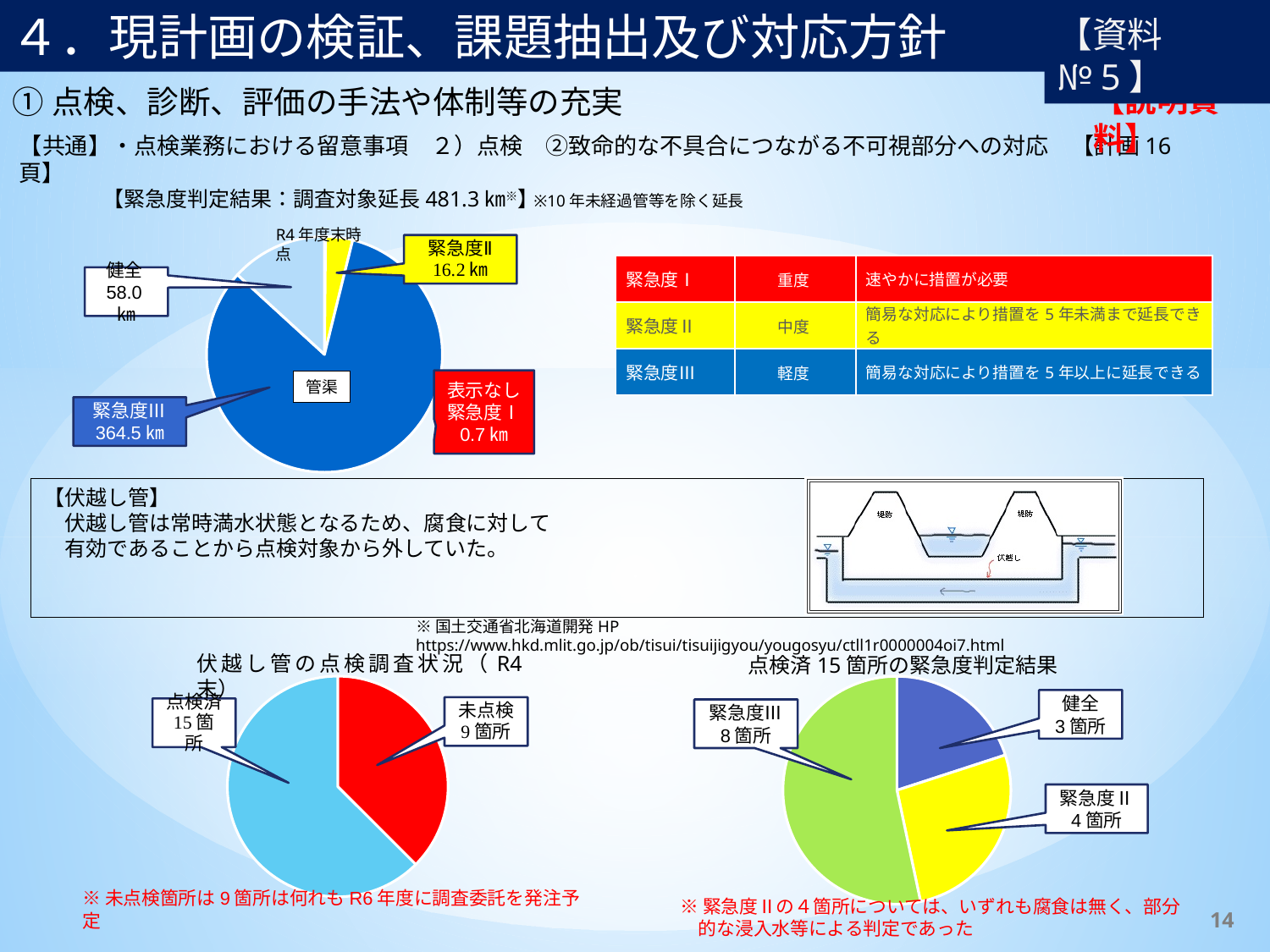
In the bottom-right pie chart (点検済15箇所の緊急度判定結果), how many locations are 緊急度Ⅱ? 4箇所 What type of chart is used for 伏越し管の点検調査状況 at the bottom left of the slide? Pie chart In the bottom-left pie chart (伏越し管の点検調査状況), how many locations are 未点検? 9箇所 In the top-left pie chart (緊急度判定結果), what is the difference between 健全 and 緊急度Ⅱ? 41.8 km In the bottom-right pie chart (点検済15箇所の緊急度判定結果), how many categories are shown? 3 In the top-left pie chart (緊急度判定結果), what is the value for 緊急度Ⅲ? 364.5 km In the top-left pie chart (緊急度判定結果), which category has the largest value? 緊急度Ⅲ In the bottom-left pie chart (伏越し管の点検調査状況), what share of the total do the 点検済 locations represent? 62.5% In the bottom-left pie chart (伏越し管の点検調査状況), which is larger, 点検済 or 未点検? 点検済 In the top-left pie chart (緊急度判定結果), what is the value for 健全? 58.0 km In the bottom-right pie chart (点検済15箇所の緊急度判定結果), which category has the most locations? 緊急度Ⅲ In the top-left pie chart (緊急度判定結果), which category has the smallest value? 緊急度Ⅰ